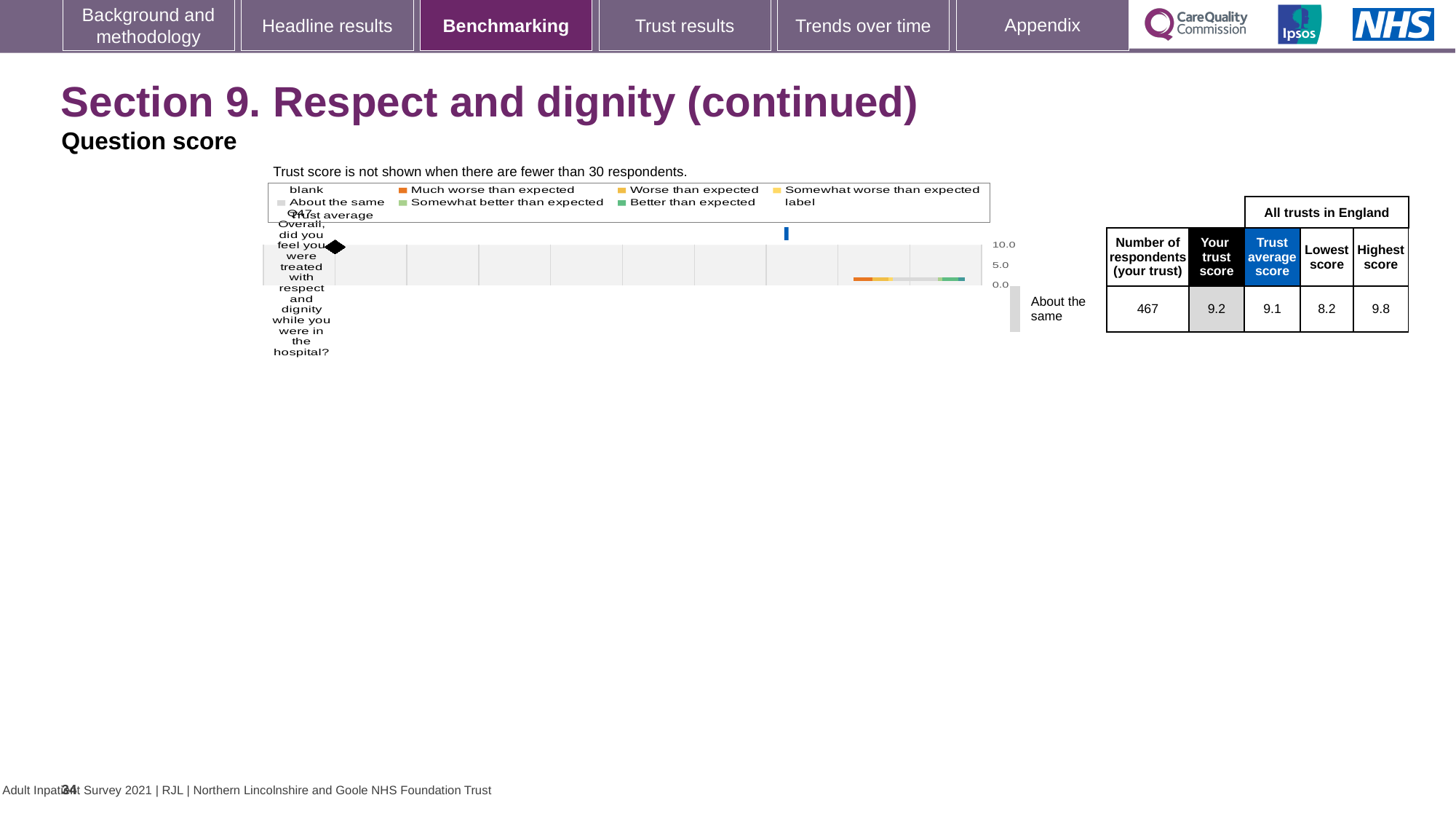
What is the highest value shown on the chart's numeric axis? 10.0 In the table beside the chart, what is the number of respondents for your trust? 467 What benchmark category is given for Q47 next to the chart? About the same What kind of chart is shown on the slide? Bar chart In the table beside the chart, what is the trust average score for Q47? 9.1 How many question categories are plotted on the chart? 1 In the table beside the chart, what is the highest score among all trusts in England? 9.8 Which question number is plotted on the chart? Q47 Is your trust score for Q47 larger or smaller than the trust average score? Larger In the table beside the chart, what is the lowest score among all trusts in England? 8.2 In the table beside the chart, what is your trust score for Q47? 9.2 What is the difference between the highest score and the lowest score in the table beside the chart? 1.6